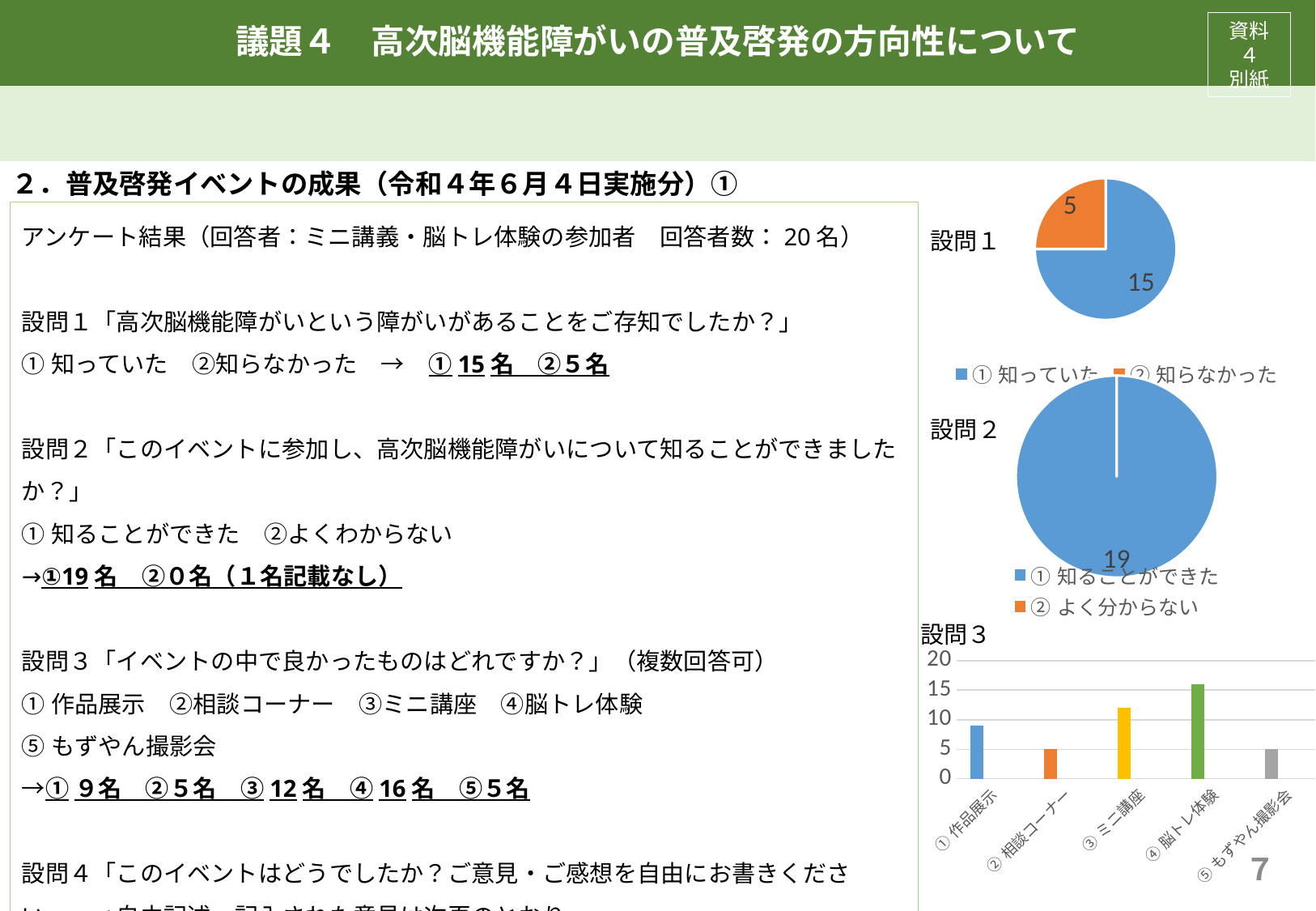
What kind of chart is the 設問1 chart? pie chart In the 設問2 pie chart, what is the value shown for ① 知ることができた? 19 How many entries does the legend of the 設問2 pie chart list? 2 What kind of chart is the 設問3 chart? bar chart In the 設問1 pie chart, what is the value for ② 知らなかった? 5 In the 設問3 bar chart, which category has the highest value? ④脳トレ体験 In the 設問3 bar chart, which is larger, ①作品展示 or ③ミニ講座? ③ミニ講座 In the 設問1 pie chart, what is the value for ① 知っていた? 15 How many categories does the 設問3 bar chart show? 5 In the 設問1 pie chart, what is the difference between ① 知っていた and ② 知らなかった? 10 In the 設問1 pie chart, what share of the total does ① 知っていた represent? 75% In the 設問3 bar chart, is the value for ④脳トレ体験 greater or less than 15? greater